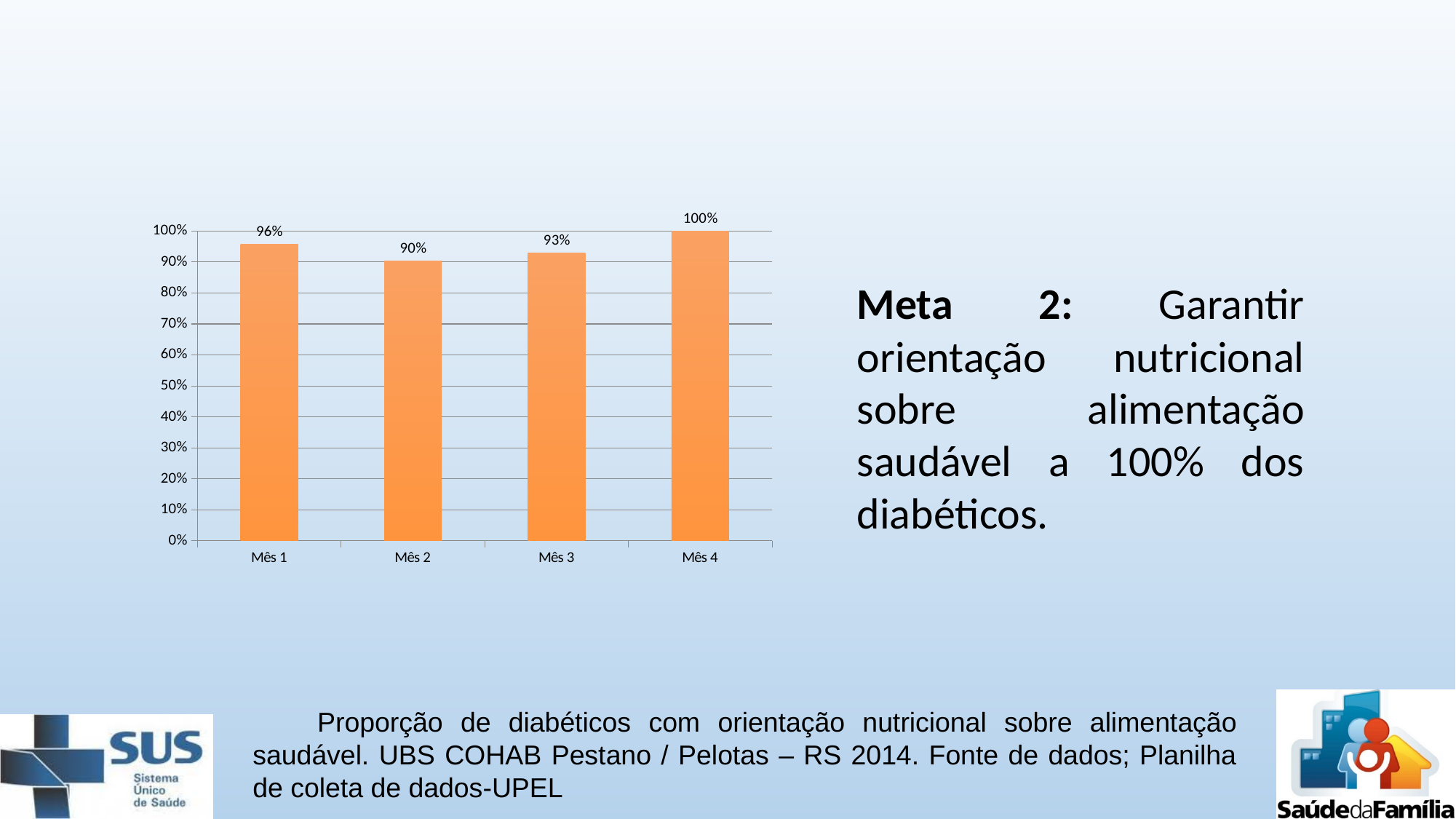
Which month has the lowest value? Mês 2 How many months are shown on the x axis? 4 What colour are the bars in the chart? Orange Which month has the highest value? Mês 4 Which is larger, the value for Mês 1 or the value for Mês 3? Mês 1 What is the value for Mês 2? 90% What is the difference between the values for Mês 4 and Mês 2? 10% What is the value for Mês 4? 100% What is the value for Mês 1? 96% What kind of chart is shown on the slide? Bar chart What is the value for Mês 3? 93% What is the difference between the values for Mês 1 and Mês 3? 3%